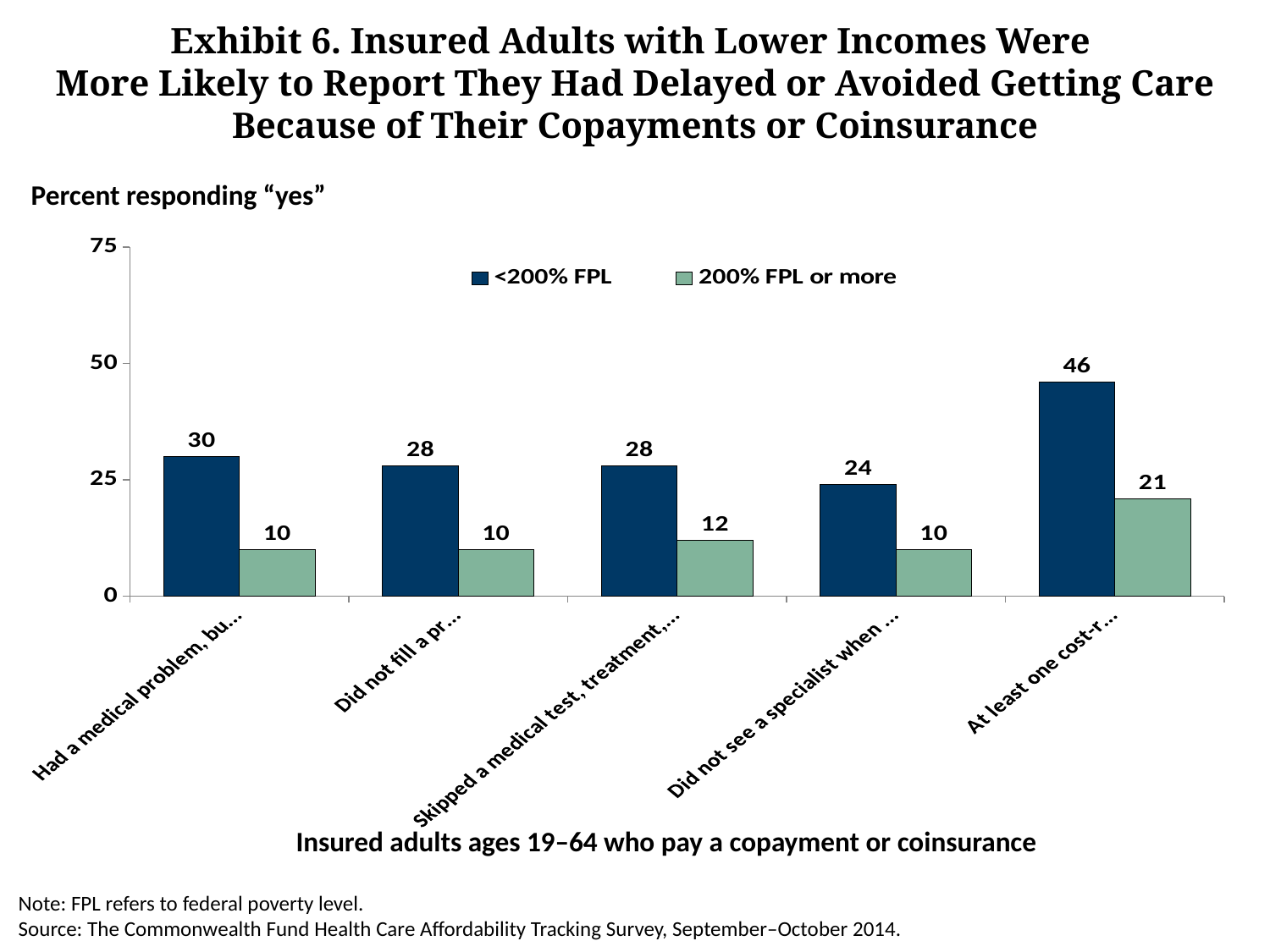
In the category "Did not see a specialist when ...", which series has the larger value, <200% FPL or 200% FPL or more? <200% FPL Which category has the highest value for the <200% FPL series? At least one cost-r... (the last category) What is the value for <200% FPL in the last category ("At least one cost-r...")? 46 What is the difference between the <200% FPL value in the first category (30) and the <200% FPL value in the fourth category (24)? 6 How many series does the legend list? 2 What is the value for <200% FPL in the first category ("Had a medical problem, bu...")? 30 What is the difference between the <200% FPL and 200% FPL or more values in the last category ("At least one cost-r...")? 25 Which category has the lowest value for the <200% FPL series? Did not see a specialist when ... (the fourth category) How many categories are shown along the x axis? 5 What does the legend say the dark blue bars represent? <200% FPL What is the value for 200% FPL or more in the category "Skipped a medical test, treatment,..."? 12 What kind of chart is shown on the slide? bar chart